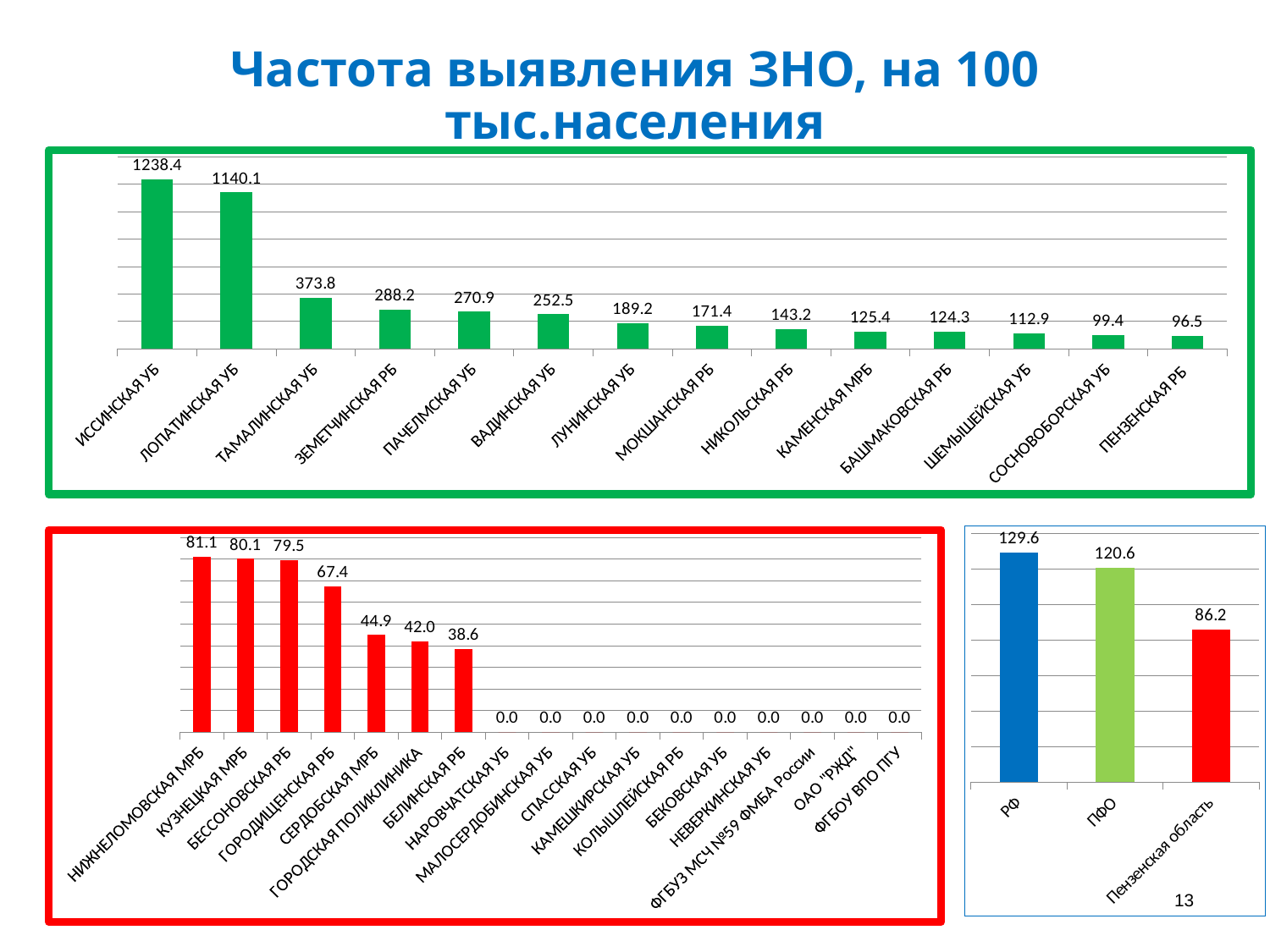
In the top chart, do the values rise or fall from left to right? fall In the top chart, what is the difference between ИССИНСКАЯ УБ and ЛОПАТИНСКАЯ УБ? 98.3 In the bottom-left chart, which category has the highest value? НИЖНЕЛОМОВСКАЯ МРБ In the top chart, which is larger: ТАМАЛИНСКАЯ УБ or ЗЕМЕТЧИНСКАЯ РБ? ТАМАЛИНСКАЯ УБ In the bottom-right chart, what is the value for Пензенская область? 86.2 In the bottom-right chart, what is the difference between РФ and ПФО? 9.0 In the top chart, which category has the lowest value? ПЕНЗЕНСКАЯ РБ In the top chart, how many categories are shown? 14 In the bottom-left chart, how many categories have a value of 0.0? 10 What type of chart is the bottom-right chart? bar chart In the bottom-left chart, what is the value for ГОРОДИЩЕНСКАЯ РБ? 67.4 In the top chart, what is the value for ИССИНСКАЯ УБ? 1238.4